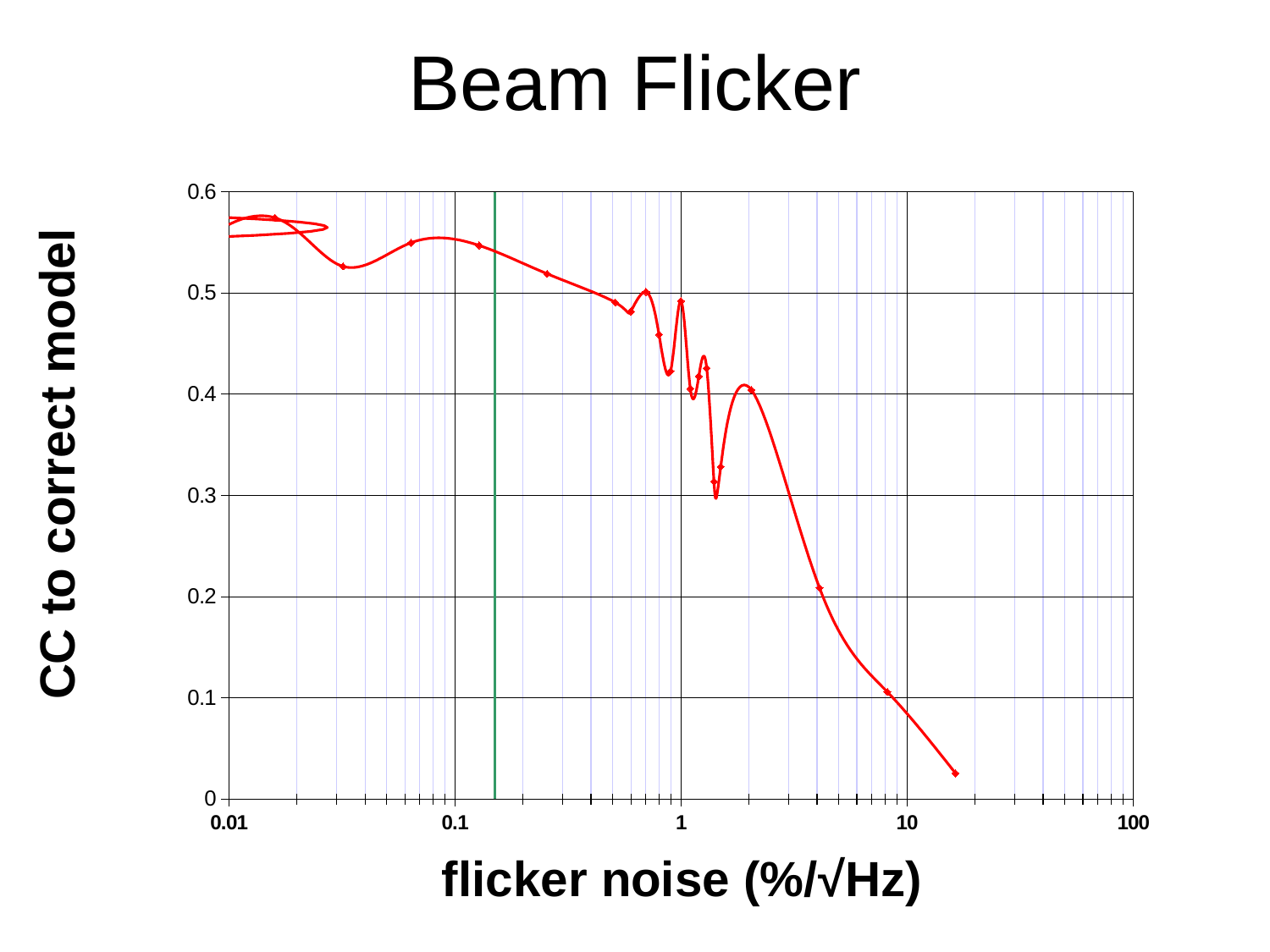
What kind of chart is shown on the slide? line chart Is the value at a flicker noise of 0.01 greater or less than the value at a flicker noise of 10? greater Overall, do the values rise or fall as flicker noise increases along the x axis? fall Is the value at a flicker noise of 0.5 greater or less than 0.4? greater What is the title of the chart? Beam Flicker Is the value at a flicker noise of 0.1 greater or less than 0.5? greater What is the label of the y axis? CC to correct model Is the value at a flicker noise of 0.01 greater or less than 0.5? greater